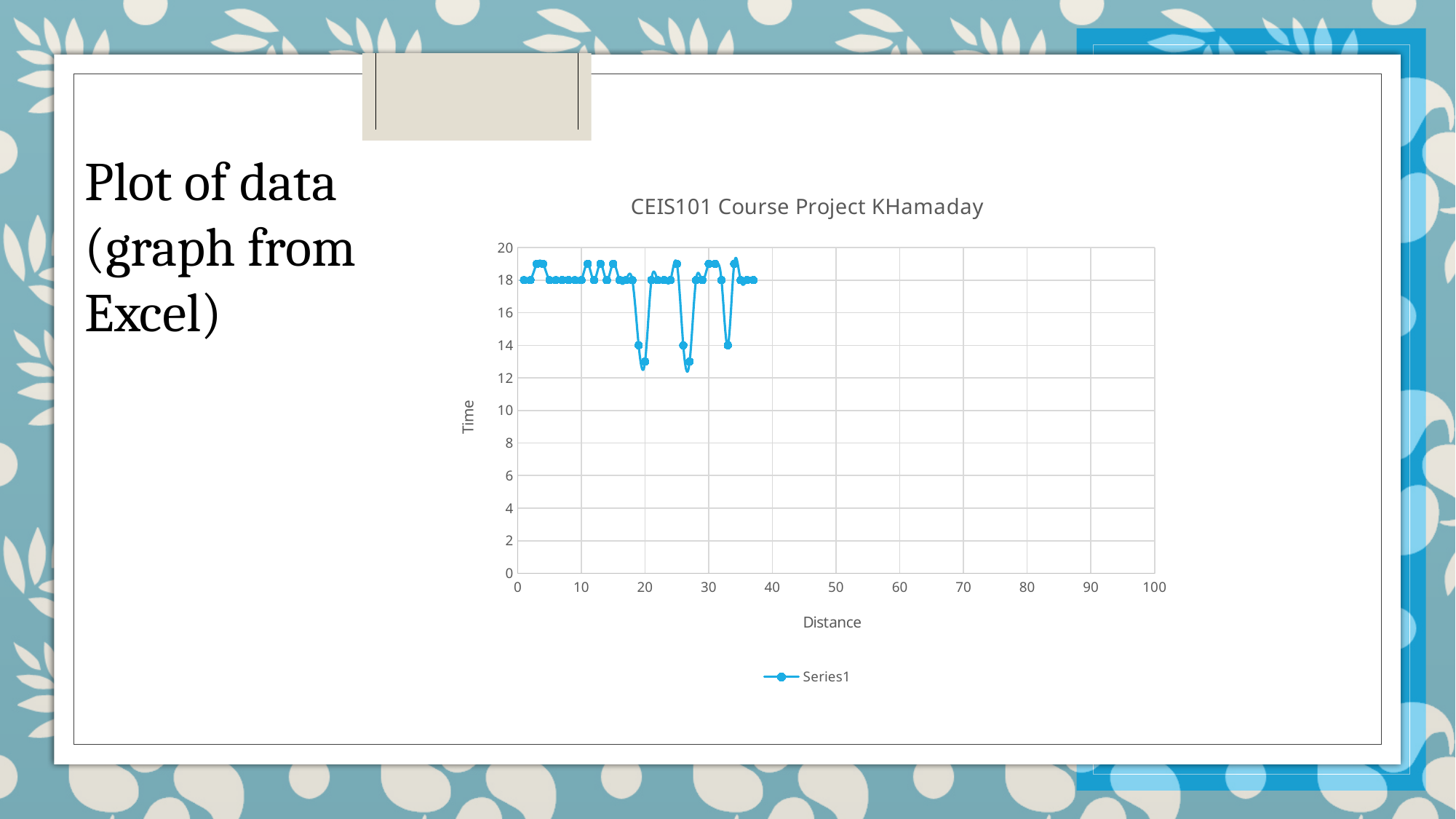
Is the lowest Time value near Distance 27 greater or less than 16? less What kind of chart is shown on the slide? line chart Do any plotted points have a Distance greater than 40? No What is the title of the chart? CEIS101 Course Project KHamaday What is the highest value shown on the y axis (Time)? 20 How many series does the legend list? 1 Is the Time value at Distance 10 greater or less than 10? greater What is the highest value shown on the x axis (Distance)? 100 Is the lowest Time value near Distance 20 greater or less than 14? less What is the label of the x axis? Distance